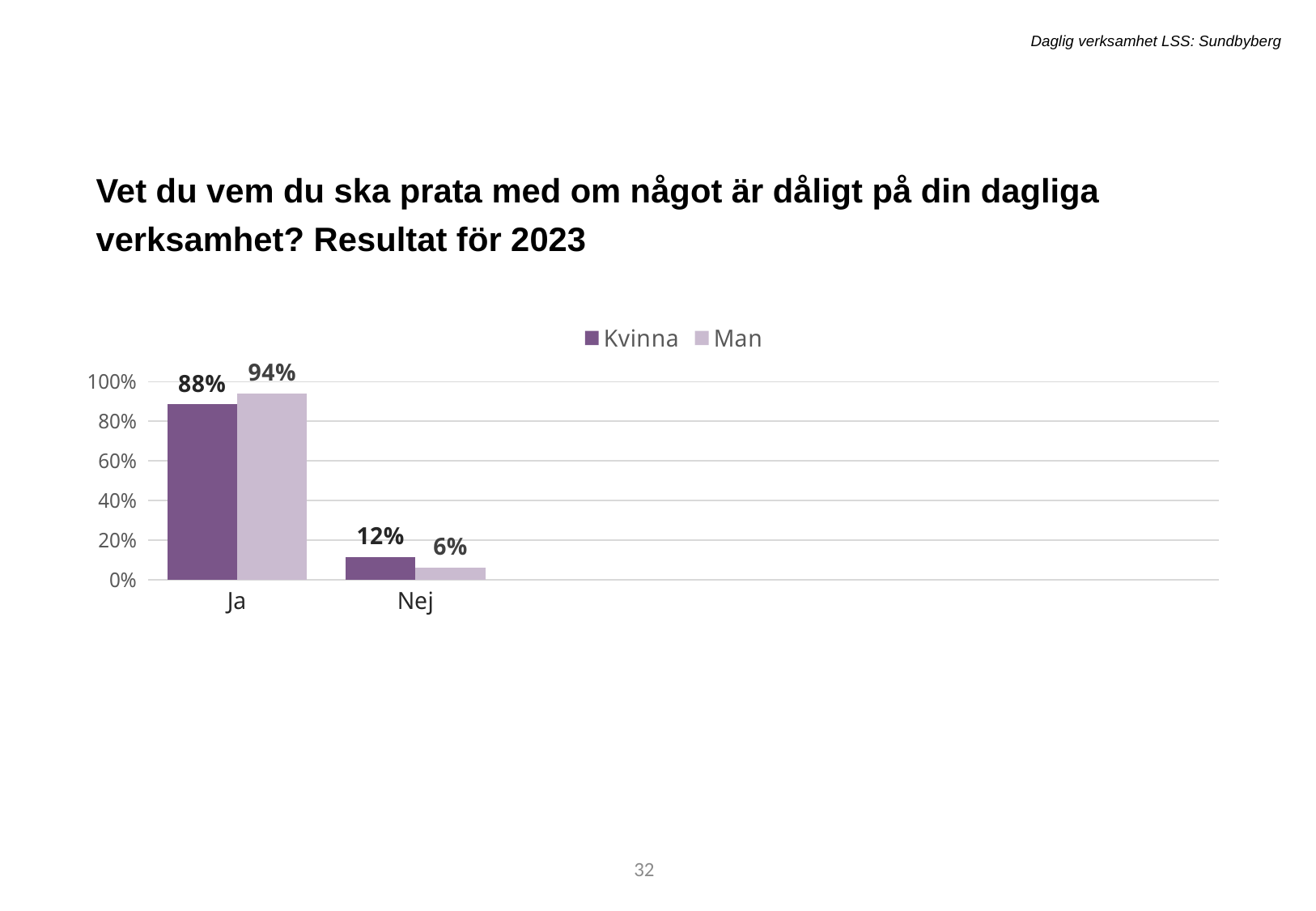
What is the value for Kvinna in the Nej category? 12% What is the difference between the Kvinna and Man values in the Nej category? 6% Which series has the higher value in the Ja category? Man What kind of chart is shown on the slide? bar chart How many categories are shown on the x axis? 2 Which series has the lower value in the Nej category? Man Is the value for Kvinna in the Ja category greater or less than 80%? greater What is the value for Man in the Nej category? 6% What is the difference between the Man and Kvinna values in the Ja category? 6% How many series does the legend list? 2 What is the value for Man in the Ja category? 94% What is the value for Kvinna in the Ja category? 88%